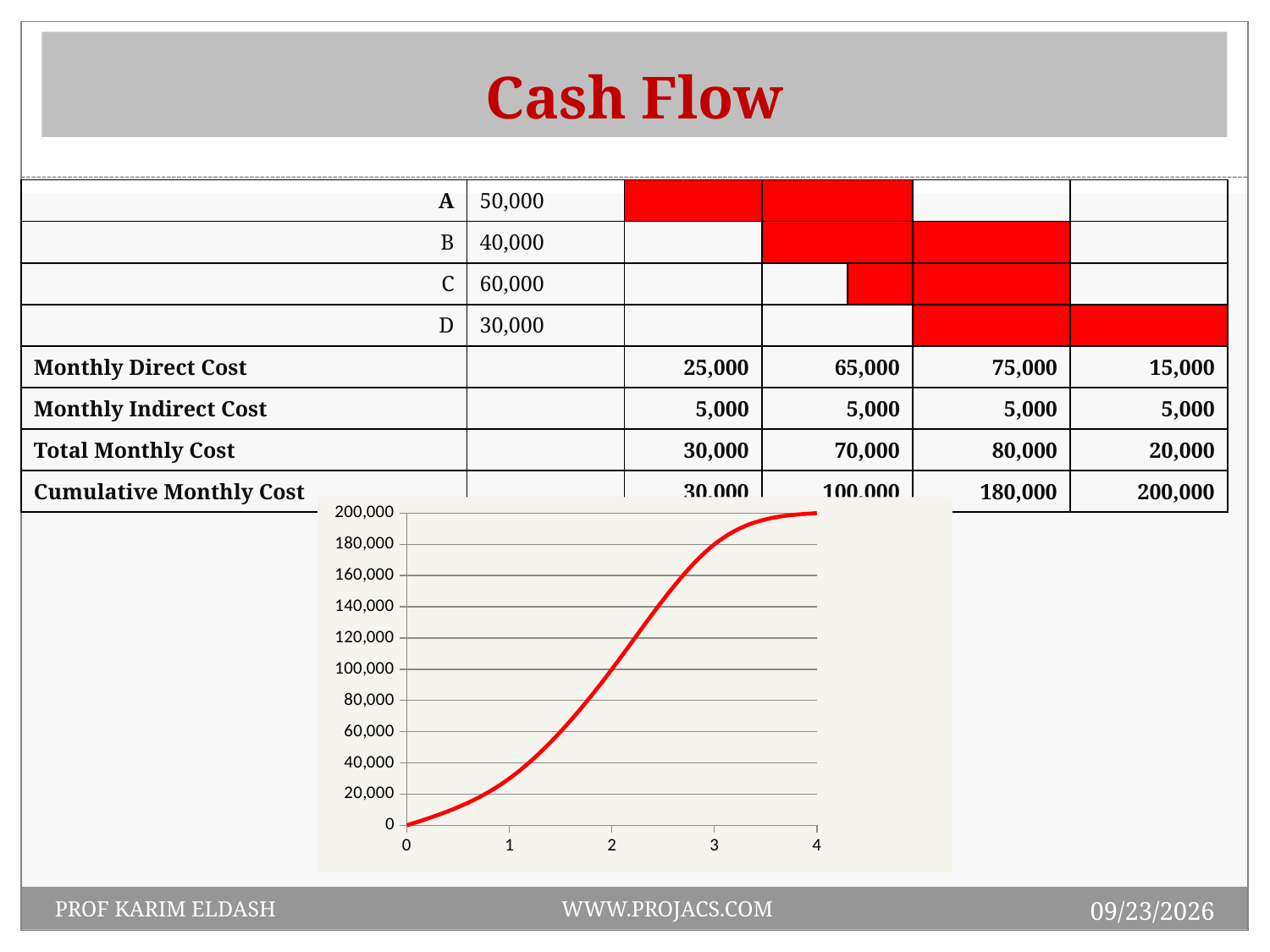
What kind of chart is shown on the slide? line chart What is the value of the line at x = 0? 0 Is the value of the line at x = 1 greater or less than 40,000? less What value does the line reach at x = 4? 200,000 Which is larger, the value of the line at x = 3 or at x = 1? x = 3 Is the value of the line at x = 1 greater or less than 20,000? greater At which x value is the line at its highest? 4 Does the plotted line rise or fall as the x axis goes from 0 to 4? rises At which x value is the line at its lowest? 0 What colour is the plotted line? red Is the value of the line at x = 2 greater or less than 80,000? greater